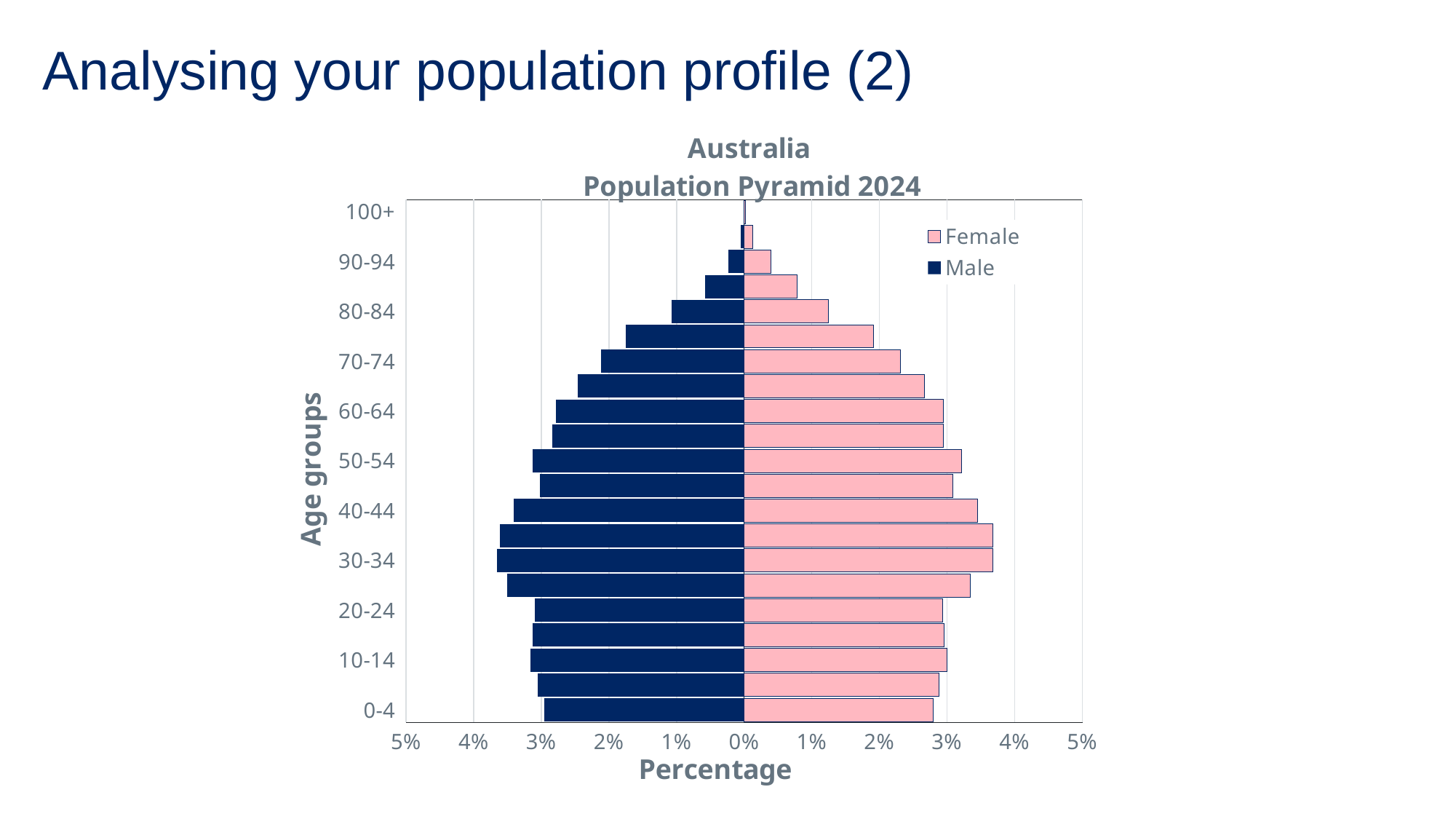
Do the Male values rise or fall as the age groups go from 40-44 up to 100+? Fall Which age group has the smallest Male value? 100+ Is the Female value for the 30-34 age group greater or less than 3%? greater What kind of chart is shown on the slide? Bar chart Is the Male value for the 90-94 age group greater or less than 1%? less Which age group has the smallest Female value? 100+ How many series does the legend list? 2 What are the two series named in the legend? Female and Male For the 80-84 age group, which is larger, the Female value or the Male value? Female What is the title of the chart? Australia Population Pyramid 2024 Is the Male value for the 0-4 age group greater or less than 2%? greater How many age groups are plotted in the pyramid? 21